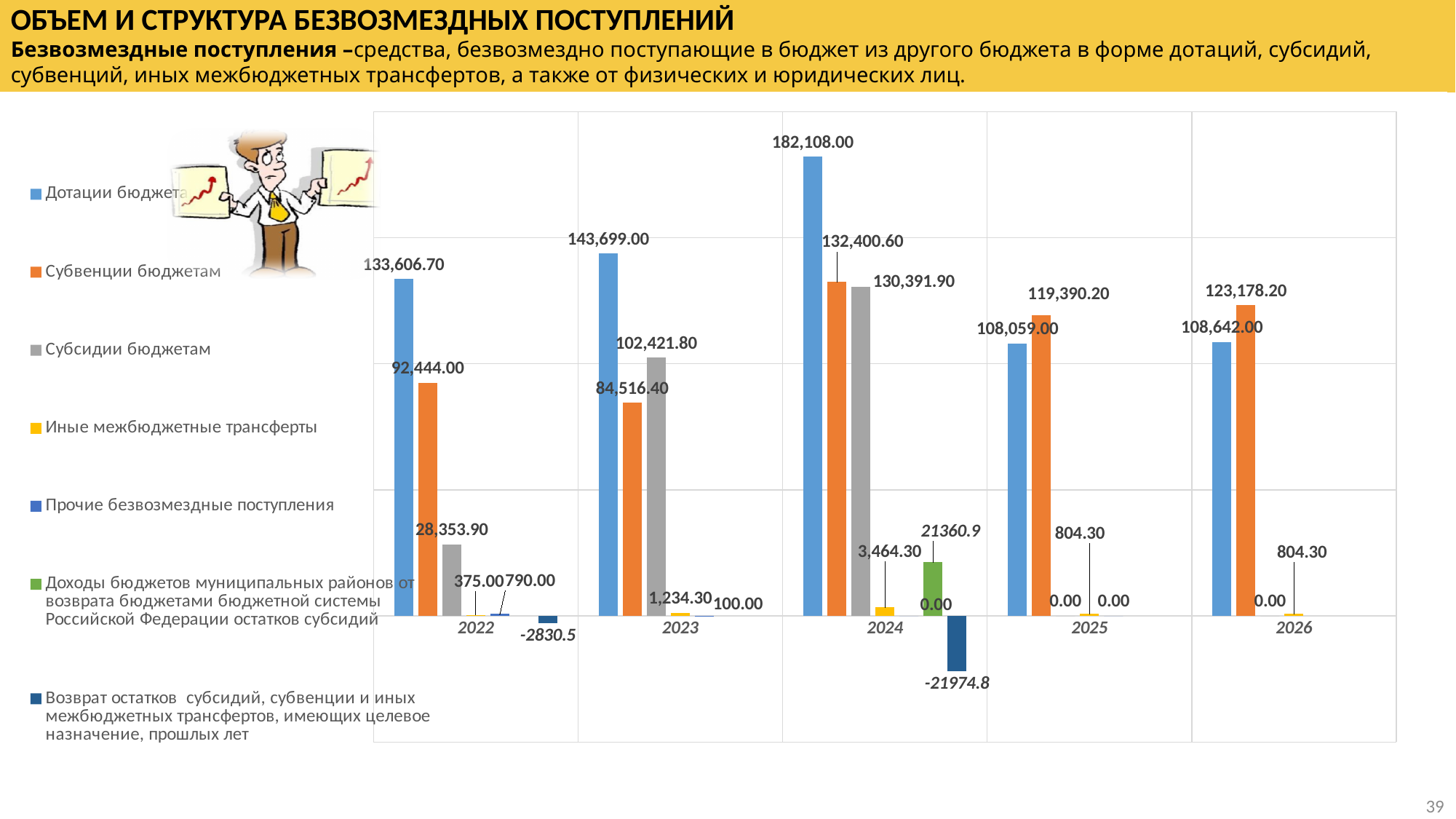
What is the value of Дотации бюджета in 2024? 182,108.00 What is the value of Субсидии бюджетам in 2022? 28,353.90 How many series does the legend list? 7 What is the value of Возврат остатков субсидий, субвенции и иных межбюджетных трансфертов in 2024? -21974.8 In which year is Дотации бюджета the highest? 2024 What is the difference between Дотации бюджета in 2024 and in 2023? 38,409.00 What kind of chart is shown on the slide? bar chart In which year is Дотации бюджета the lowest? 2025 What is the value of Субвенции бюджетам in 2022? 92,444.00 How many years are shown on the x axis of the chart? 5 What is the value of Субсидии бюджетам in 2023? 102,421.80 In 2025, which is larger: Дотации бюджета or Субвенции бюджетам? Субвенции бюджетам